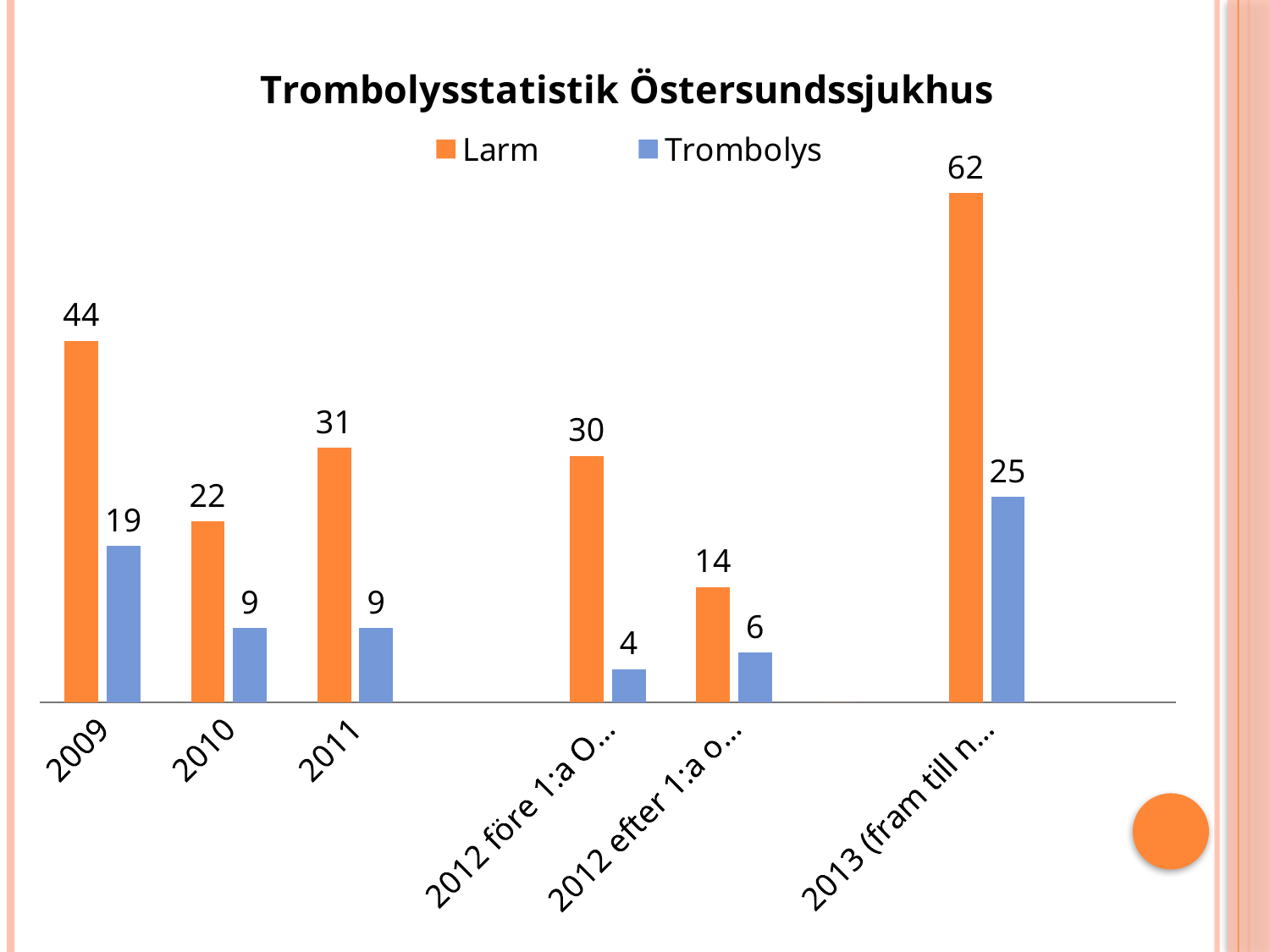
How many series does the legend list? 2 What is the Larm value for 2009? 44 What is the difference between the Larm and Trombolys values for 2011? 22 Which category has the highest Larm value? 2013 (fram till n... What is the Larm value for the category labelled "2012 efter 1:a o..."? 14 What is the Trombolys value for 2010? 9 What is the Trombolys value for the category labelled "2013 (fram till n..."? 25 Which is larger, the Larm value for 2010 or the Larm value for 2011? 2011 What is the title of the chart? Trombolysstatistik Östersundssjukhus How many categories are shown on the x axis? 6 What kind of chart is shown on the slide? Bar chart Which category has the lowest Trombolys value? 2012 före 1:a O...